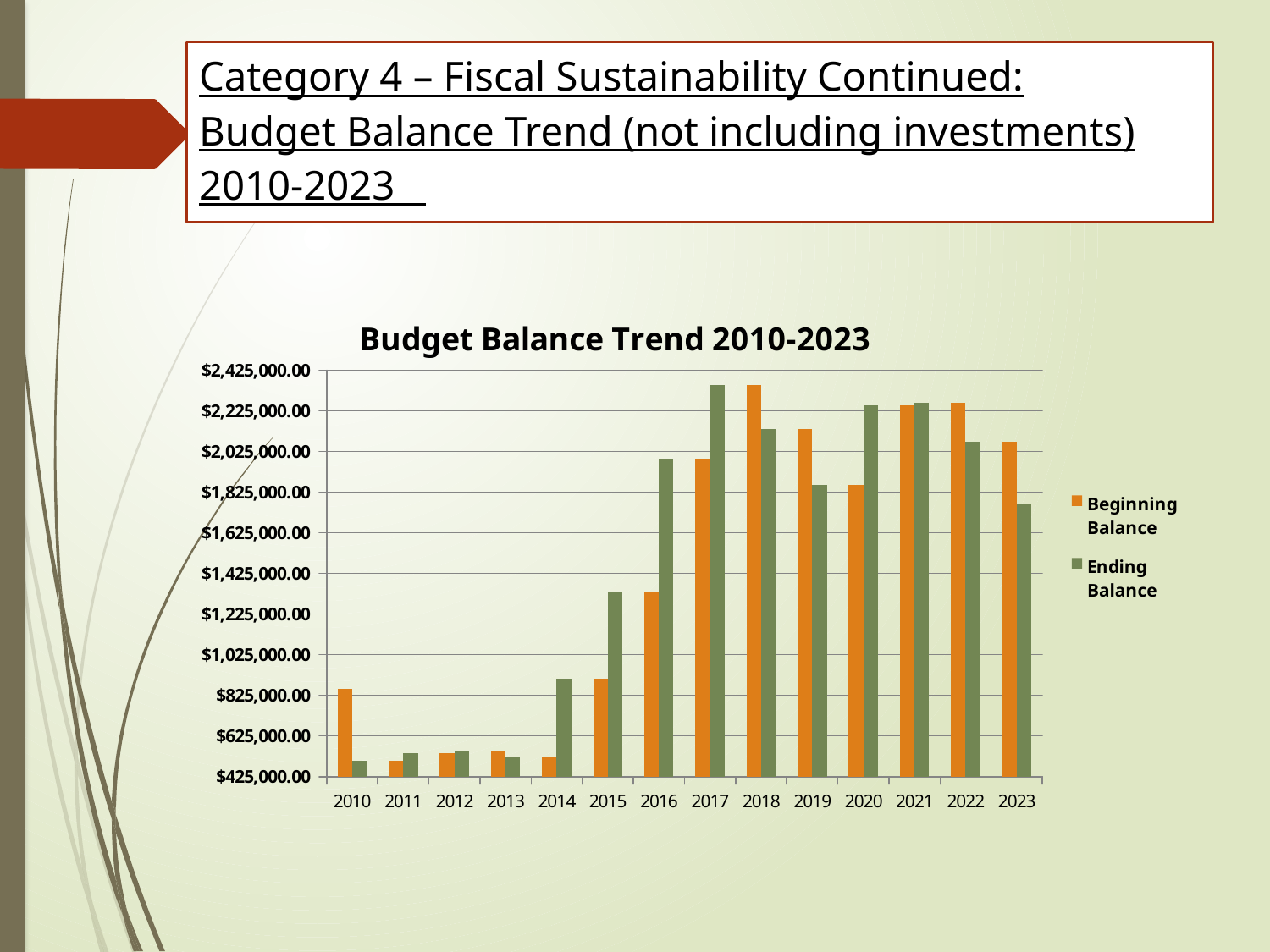
Does the Beginning Balance rise or fall from 2014 to 2018? Rise How many series does the legend list? 2 Is the Ending Balance for 2023 greater or less than $1,825,000.00? less Is the Beginning Balance for 2011 greater or less than $625,000.00? less In 2023, which is larger: the Beginning Balance or the Ending Balance? Beginning Balance In 2016, which is larger: the Beginning Balance or the Ending Balance? Ending Balance Which year has the highest Beginning Balance? 2018 Is the Ending Balance for 2014 greater or less than $1,025,000.00? less Which year has the highest Ending Balance? 2017 What kind of chart is shown on the slide? Bar chart How many years are shown on the x axis of the chart? 14